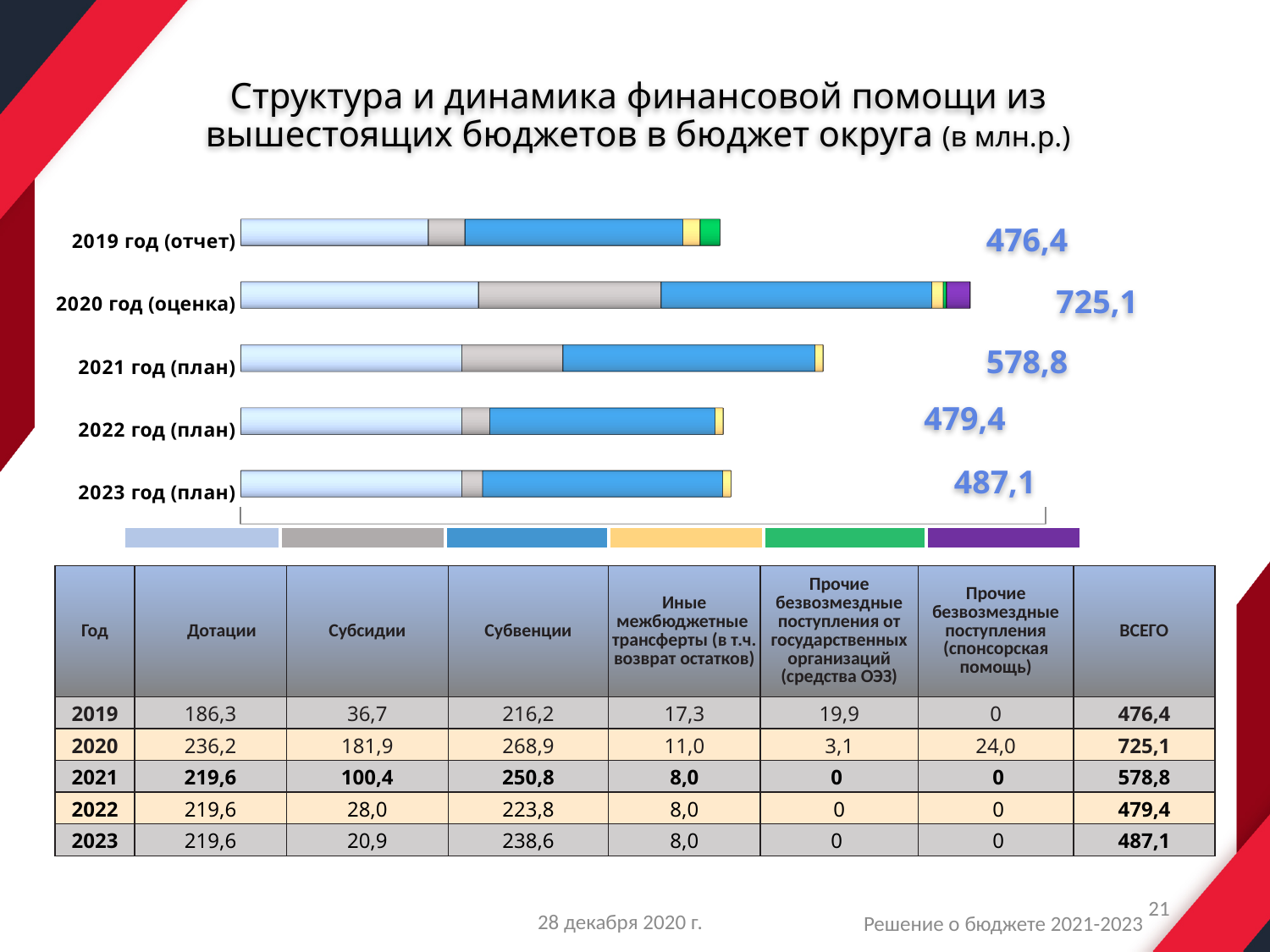
What is the total value labelled for 2023 год (план)? 487,1 What is the difference between the totals for 2020 год (оценка) and 2021 год (план)? 146,3 How many years (bars) are plotted in the chart? 5 How many colour entries does the chart legend show? 6 What is the total value labelled for 2020 год (оценка)? 725,1 What is the total value labelled for 2019 год (отчет)? 476,4 Which year has the lowest total in the chart? 2019 год (отчет) Which year has the highest total in the chart? 2020 год (оценка) What kind of chart is shown on the slide? Stacked bar chart What is the difference between the totals for 2023 год (план) and 2022 год (план)? 7,7 Which has the larger total: 2021 год (план) or 2022 год (план)? 2021 год (план) From 2020 год (оценка) to 2022 год (план), do the bar totals rise or fall? Fall